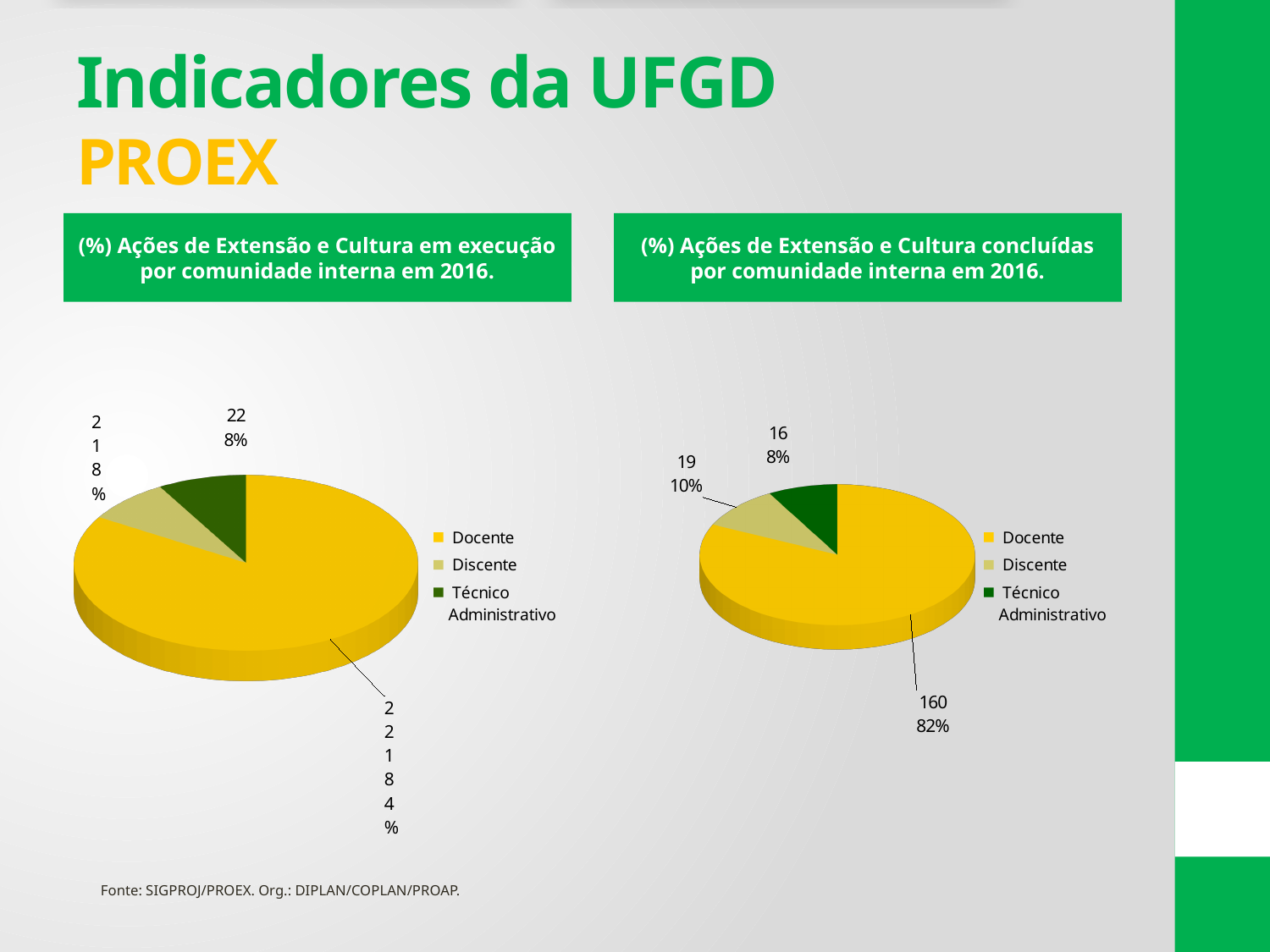
In the chart '(%) Ações de Extensão e Cultura concluídas por comunidade interna em 2016', what is the value for Discente? 19 How many categories does the legend list in the chart '(%) Ações de Extensão e Cultura em execução por comunidade interna em 2016'? 3 In the chart '(%) Ações de Extensão e Cultura em execução por comunidade interna em 2016', what is the value for Técnico Administrativo? 22 What kind of chart is used for '(%) Ações de Extensão e Cultura concluídas por comunidade interna em 2016'? Pie chart In the chart '(%) Ações de Extensão e Cultura concluídas por comunidade interna em 2016', what is the total of the three values shown? 195 In the chart '(%) Ações de Extensão e Cultura concluídas por comunidade interna em 2016', what is the value for Técnico Administrativo? 16 What source is cited at the bottom of the slide for the charts? SIGPROJ/PROEX. Org.: DIPLAN/COPLAN/PROAP. In the chart '(%) Ações de Extensão e Cultura em execução por comunidade interna em 2016', which category has the largest slice? Docente In the chart '(%) Ações de Extensão e Cultura concluídas por comunidade interna em 2016', which category has the largest slice? Docente In the chart '(%) Ações de Extensão e Cultura concluídas por comunidade interna em 2016', what percentage share does Docente have? 82% In the chart '(%) Ações de Extensão e Cultura concluídas por comunidade interna em 2016', what is the difference between the Docente value and the Discente value? 141 In the chart '(%) Ações de Extensão e Cultura concluídas por comunidade interna em 2016', which category has the smallest slice? Técnico Administrativo